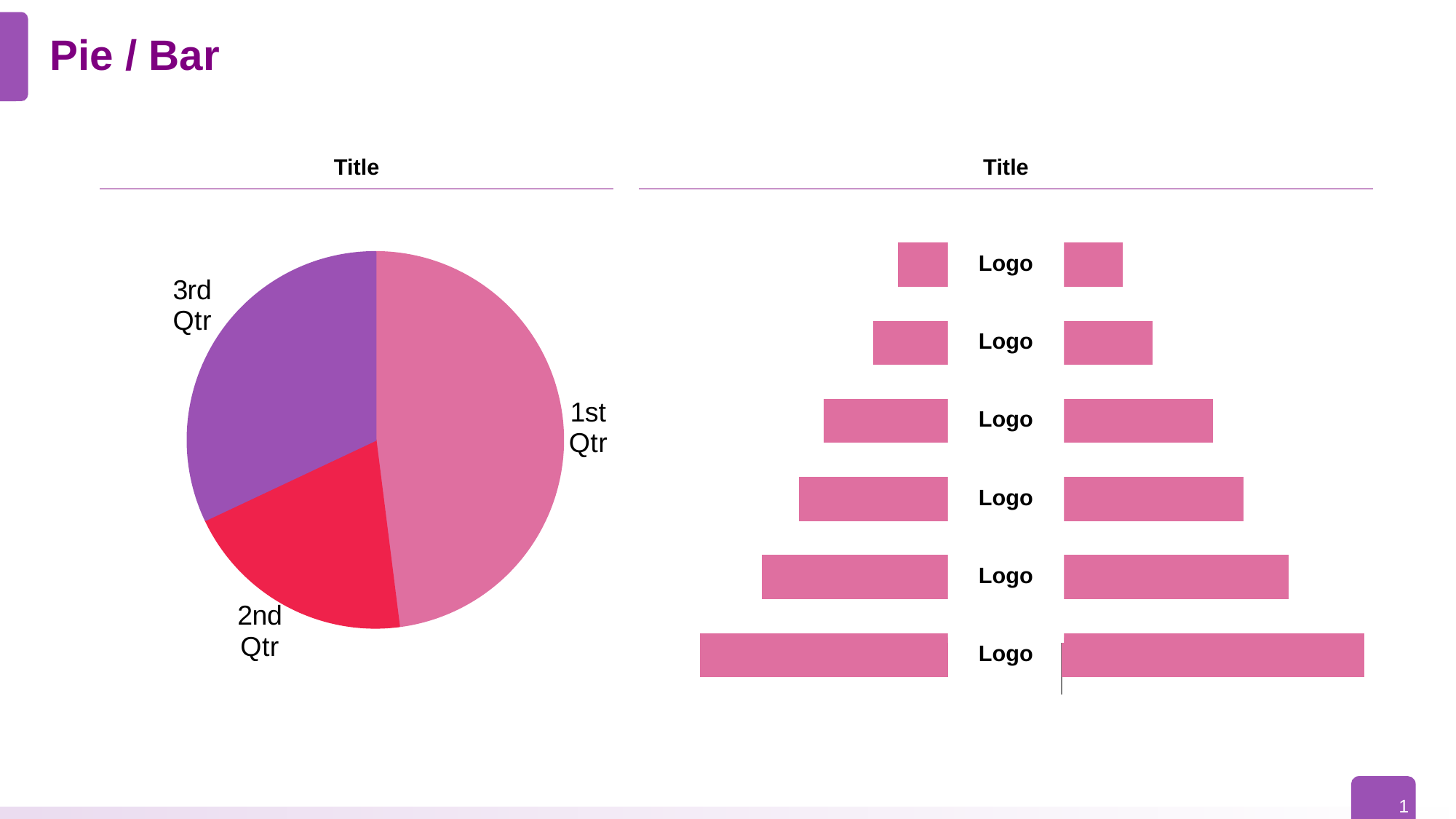
In the pie chart on the left, which slice is the smallest? 2nd Qtr In the bar chart on the right, what label is shown between the bars in each row? Logo In the pie chart on the left, what colour is the 3rd Qtr slice? purple In the pie chart on the left, which slice is larger, 2nd Qtr or 3rd Qtr? 3rd Qtr In the pie chart on the left, which slice is the largest? 1st Qtr In the bar chart on the right, do the bars get longer or shorter going from the top row to the bottom row? longer What kind of chart is the chart on the right of the slide? bar chart In the bar chart on the right, how many rows of bars are there? 6 In the pie chart on the left, how many slices are there? 3 What kind of chart is the chart on the left of the slide? pie chart In the pie chart on the left, which slice is larger, 1st Qtr or 3rd Qtr? 1st Qtr